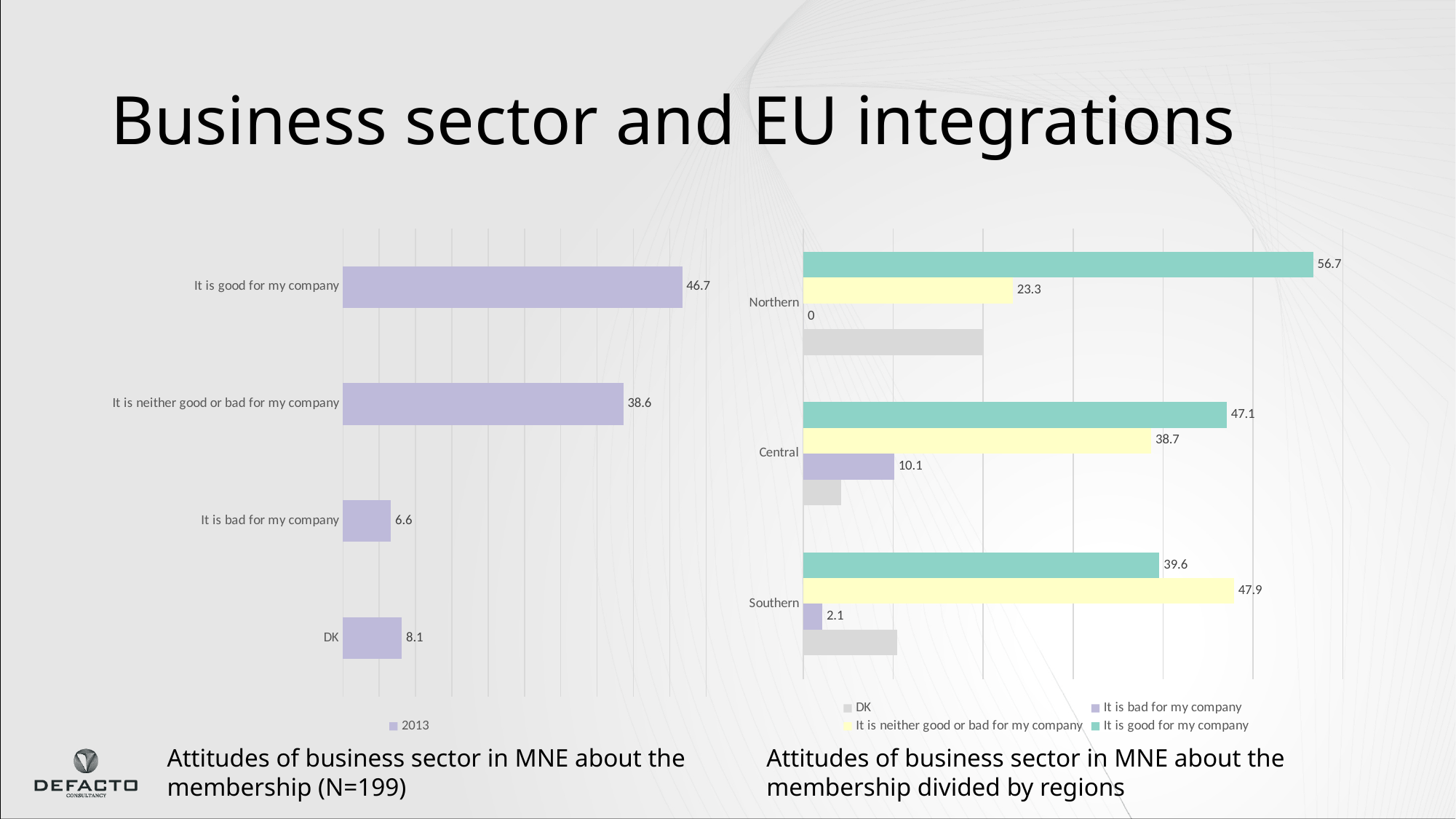
In the left chart (Attitudes of business sector in MNE about the membership, N=199), what is the value for "It is good for my company"? 46.7 In the right chart (divided by regions), is "It is good for my company" or "It is neither good or bad for my company" larger for Southern? It is neither good or bad for my company What kind of chart is the right chart (divided by regions)? Bar chart In the left chart (N=199), what is the difference between "It is good for my company" and "It is neither good or bad for my company"? 8.1 In the left chart (N=199), how many categories are shown? 4 In the left chart (N=199), what series does the legend list? 2013 In the left chart (N=199), which category has the lowest value? It is bad for my company In the right chart (divided by regions), which region has the highest value for "It is neither good or bad for my company"? Southern In the right chart (divided by regions), what is the value of "It is good for my company" for Northern? 56.7 In the right chart (divided by regions), what is the value of "It is bad for my company" for Central? 10.1 In the right chart (divided by regions), what is the difference between "It is good for my company" for Northern and for Central? 9.6 In the right chart (divided by regions), how many series does the legend list? 4